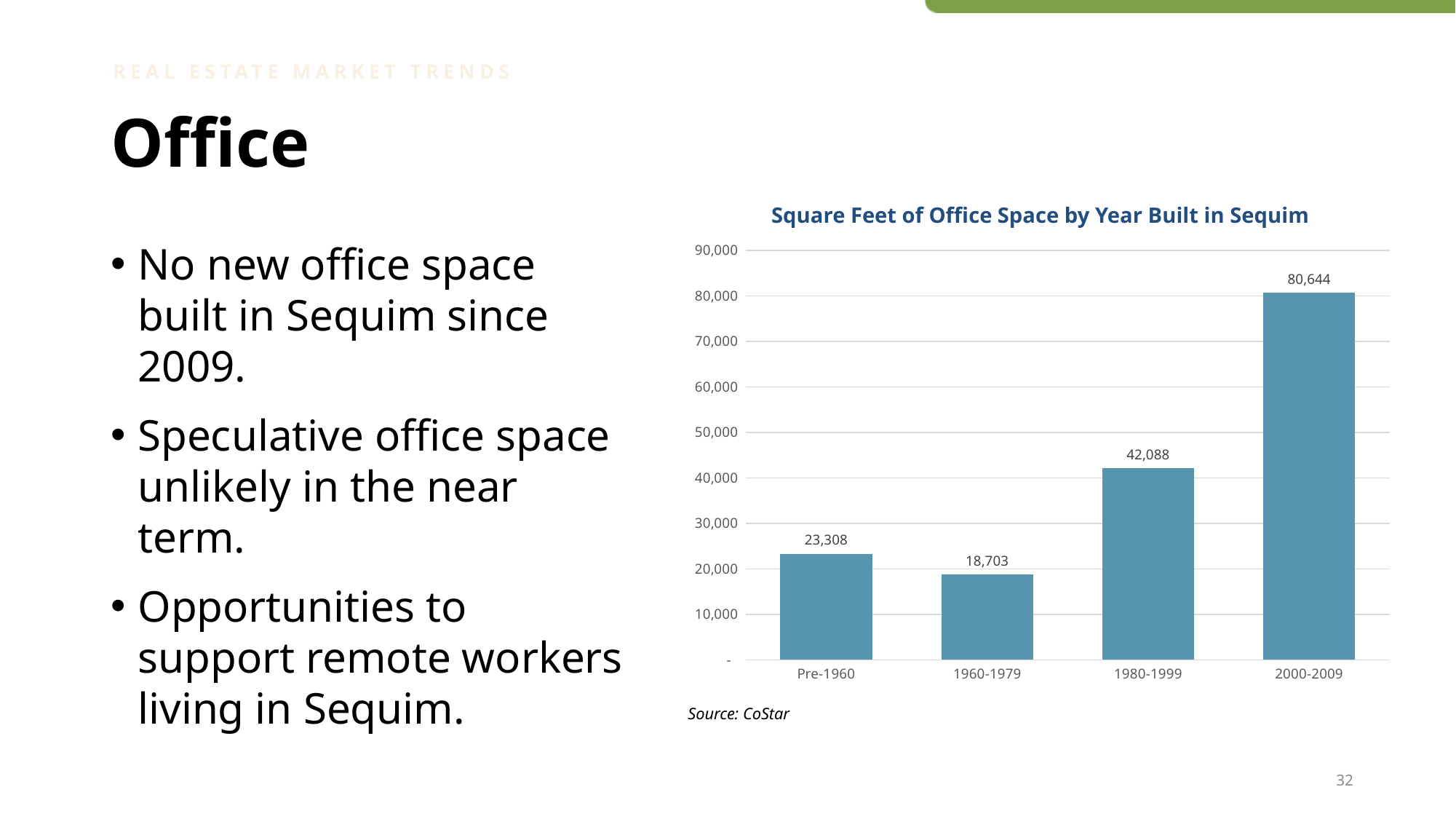
Which has more office space, Pre-1960 or 1960-1979? Pre-1960 What is the title of the chart? Square Feet of Office Space by Year Built in Sequim Which year-built period has the least office space? 1960-1979 How many year-built categories are shown in the chart? 4 What is the square feet of office space built in 1960-1979? 18,703 What is the difference in square feet between the 2000-2009 and 1980-1999 periods? 38,556 Is the value for 1980-1999 greater or less than 40,000? greater What kind of chart is shown on the slide? Bar chart What is the square feet of office space built Pre-1960? 23,308 Which year-built period has the most office space? 2000-2009 What is the square feet of office space built in 2000-2009? 80,644 What is the square feet of office space built in 1980-1999? 42,088